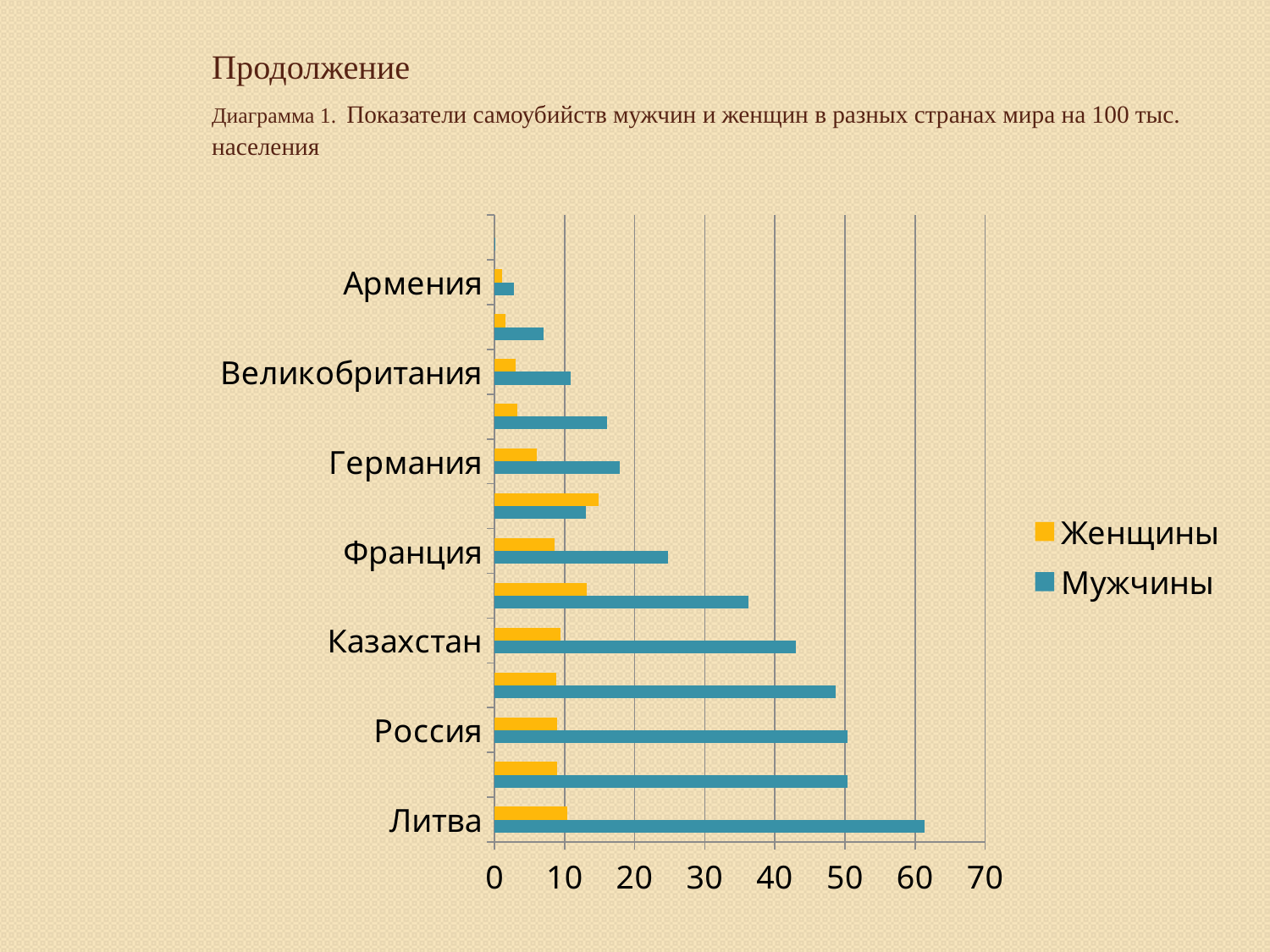
Is the Мужчины value for Россия greater or less than 40? greater What kind of chart is shown on the slide? bar chart Is the Мужчины value for Франция greater or less than 20? greater For Литва, which series has the larger value, Женщины or Мужчины? Мужчины Is the Мужчины value for Казахстан greater or less than 40? greater What are the two series named in the legend? Женщины and Мужчины Which country has the highest value for Мужчины? Литва How many series does the legend list? 2 Which is larger, the Мужчины value for Франция or for Германия? Франция